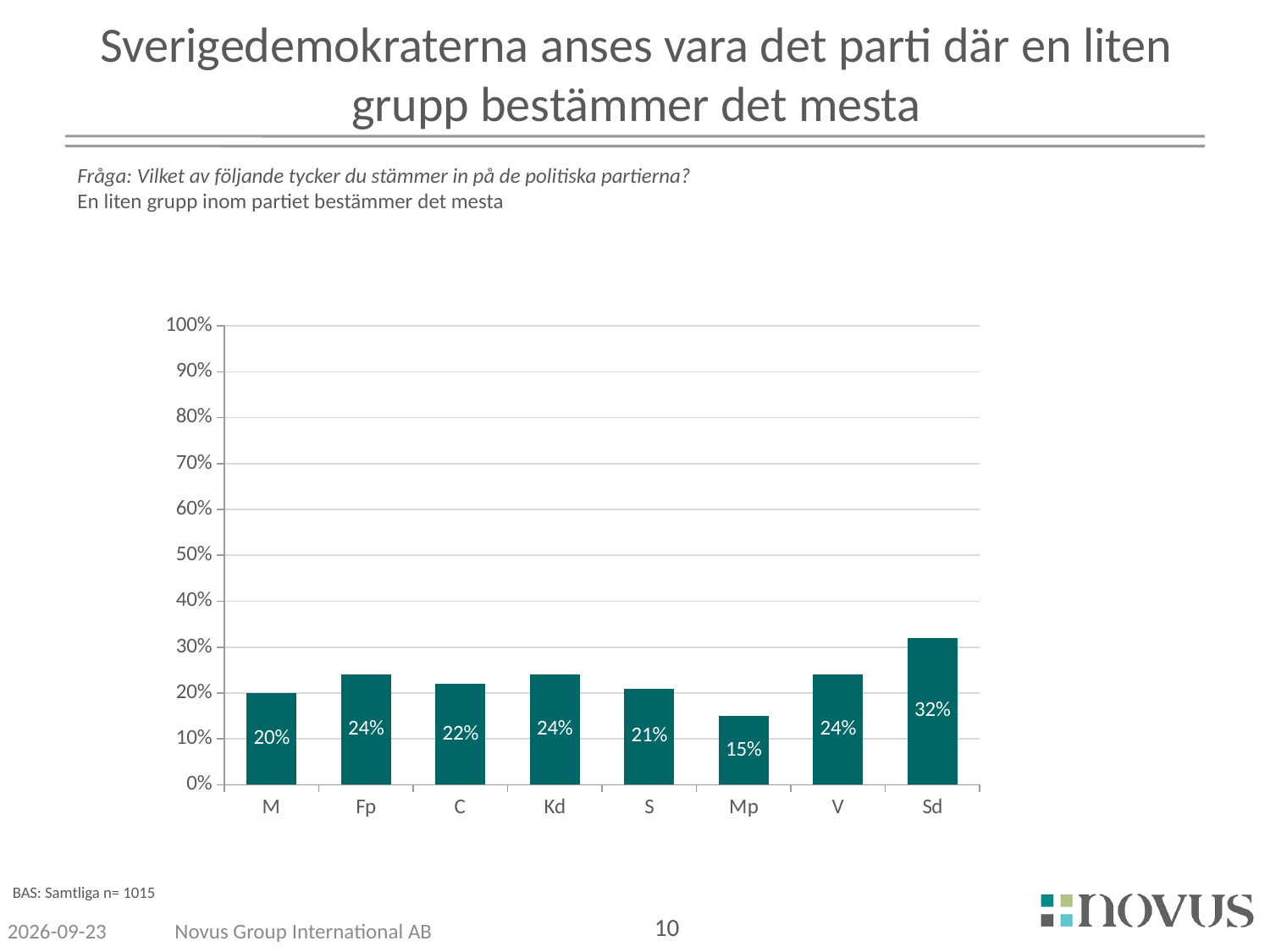
What is the value for Mp? 15% What is the value for M? 20% What kind of chart is shown on the slide? bar chart What is the value for Sd? 32% Which party has the lowest value? Mp What is the difference between the values for Sd and Mp? 17% Which is larger, the value for S or the value for Fp? Fp How many parties are shown on the x axis? 8 What is the highest value shown on the y axis? 100% Which party has the highest value? Sd Is the value for Sd greater or less than 30%? greater What is the value for C? 22%